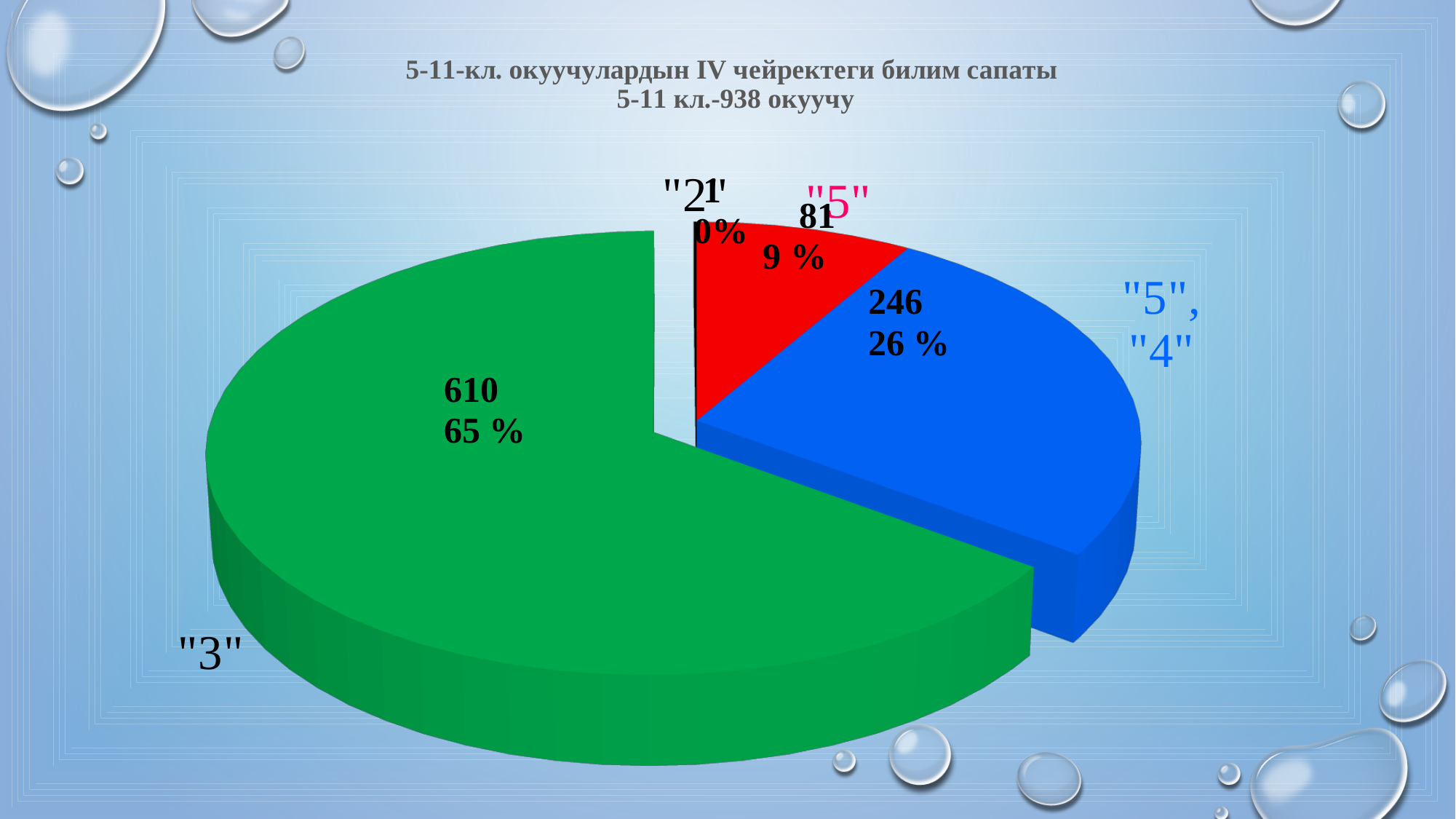
What is the value shown for the "2" slice? 1 Which slice is the largest? "3" What is the value shown for the "3" slice? 610 What percentage is shown for the "5", "4" slice? 26 % What is the difference between the values for the "3" slice and the "5", "4" slice? 364 Which slice is the smallest? "2" What percentage is shown for the "3" slice? 65 % What percentage is shown for the "5" slice? 9 % What is the value shown for the "5" slice? 81 What is the value shown for the "5", "4" slice? 246 How many slices does the pie chart have? 4 What kind of chart is shown on the slide? pie chart